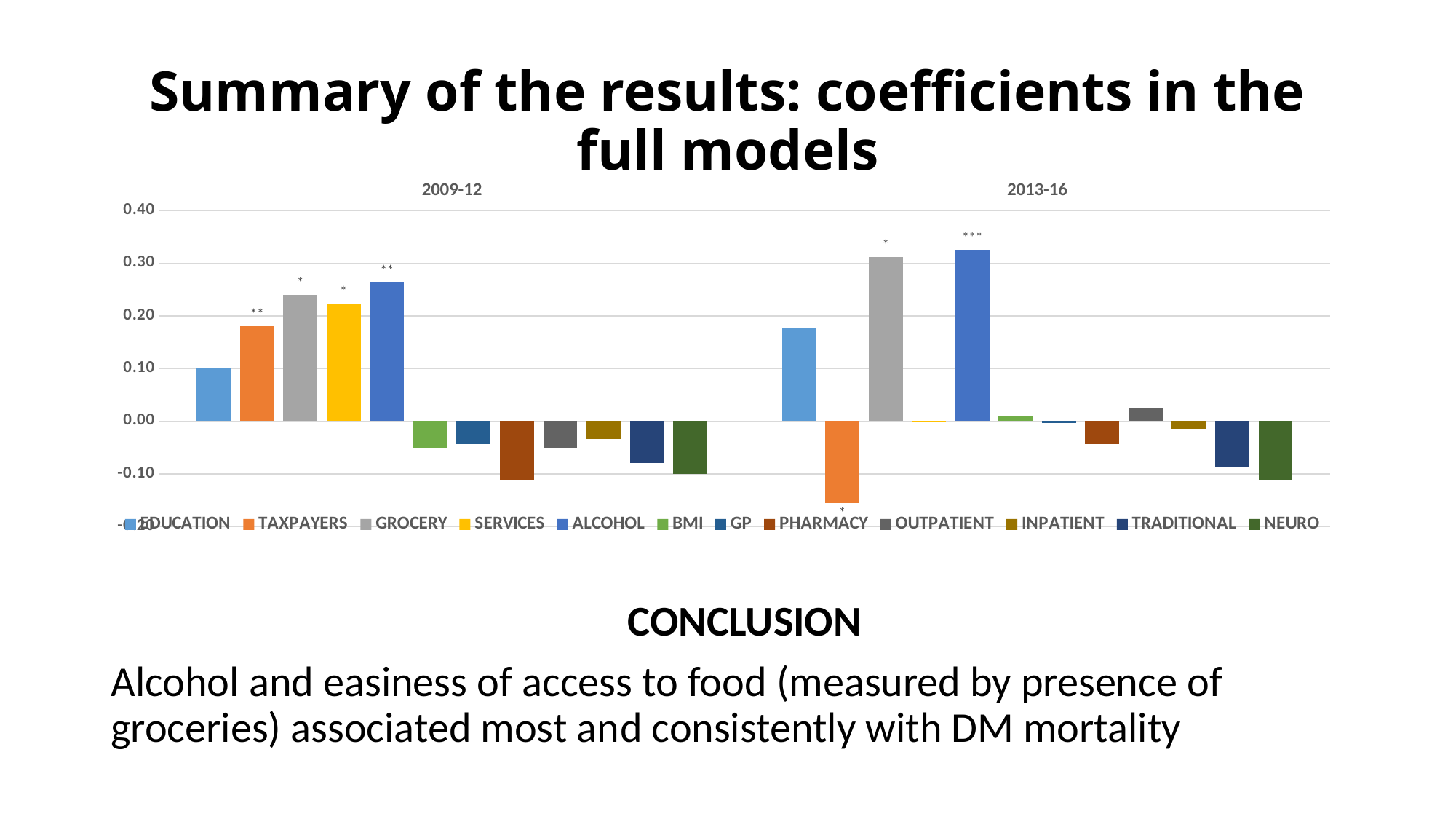
Is the TAXPAYERS coefficient for 2013-16 greater or less than -0.10? less Is the ALCOHOL coefficient for 2013-16 greater or less than 0.30? greater Is the EDUCATION coefficient for 2013-16 greater or less than 0.20? less What kind of chart is shown on the slide? bar chart Which series has the highest coefficient in the 2013-16 group? ALCOHOL Which series has the highest coefficient in the 2009-12 group? ALCOHOL How many period categories are shown on the x axis? 2 Which is larger, the ALCOHOL coefficient for 2009-12 or for 2013-16? 2013-16 What is the title of the slide containing the chart? Summary of the results: coefficients in the full models Which series has the lowest coefficient in the 2013-16 group? TAXPAYERS How many series does the legend list? 12 Does the ALCOHOL coefficient rise or fall from 2009-12 to 2013-16? rise